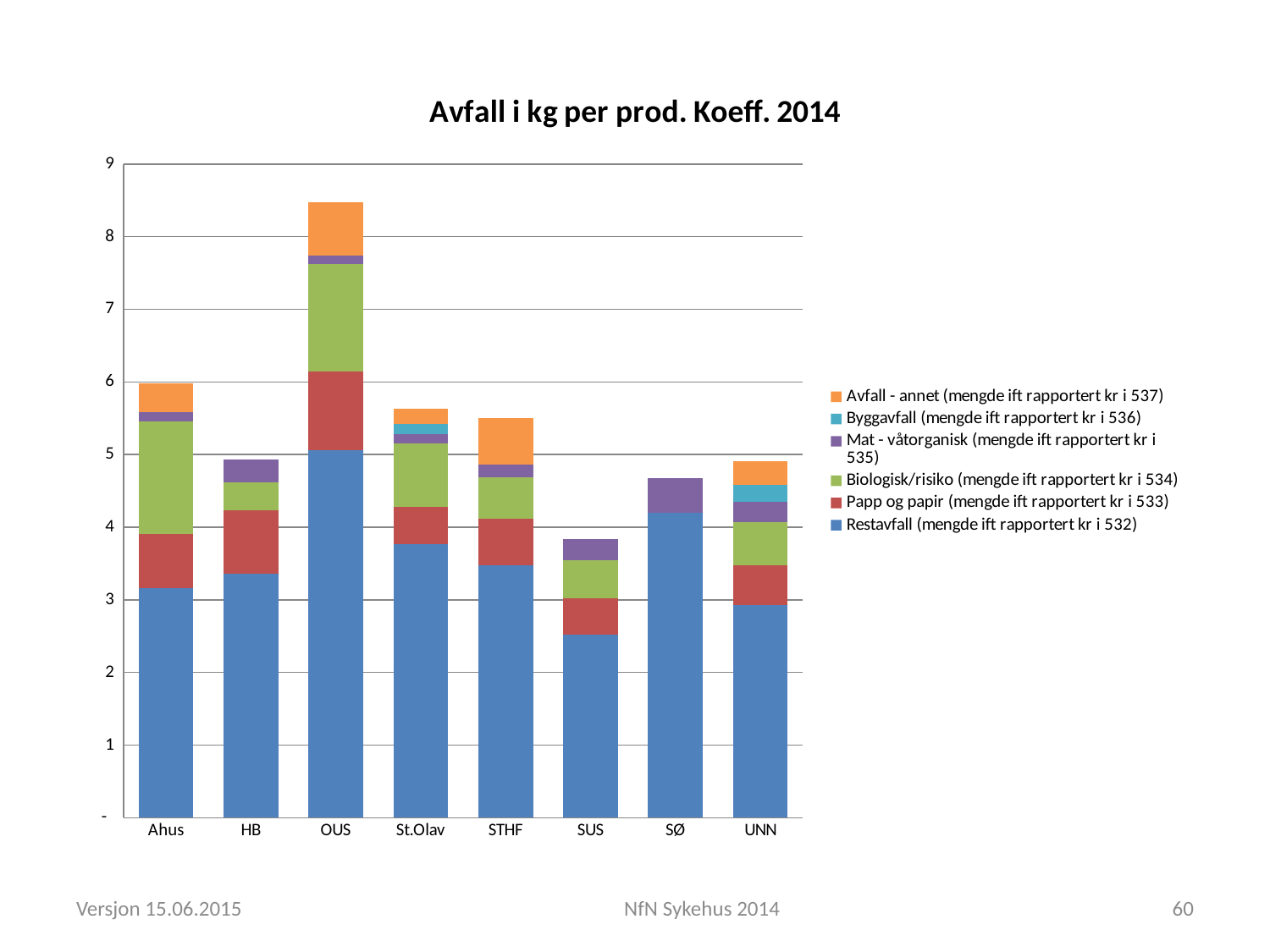
Is the Restavfall value for SUS greater or less than 3? less Is the Restavfall value for SØ greater or less than 4? greater Is the total stacked value for SUS greater or less than 4? less How many series does the legend list? 6 Which series is plotted at the bottom of each stacked bar? Restavfall (mengde ift rapportert kr i 532) How many hospitals (categories) are shown on the x axis? 8 What kind of chart is shown on the slide? Stacked bar chart Which hospital has the lowest total stacked bar? SUS What is the title of the chart? Avfall i kg per prod. Koeff. 2014 Which has the larger total stacked bar, HB or SUS? HB Which hospital has the highest total stacked bar? OUS